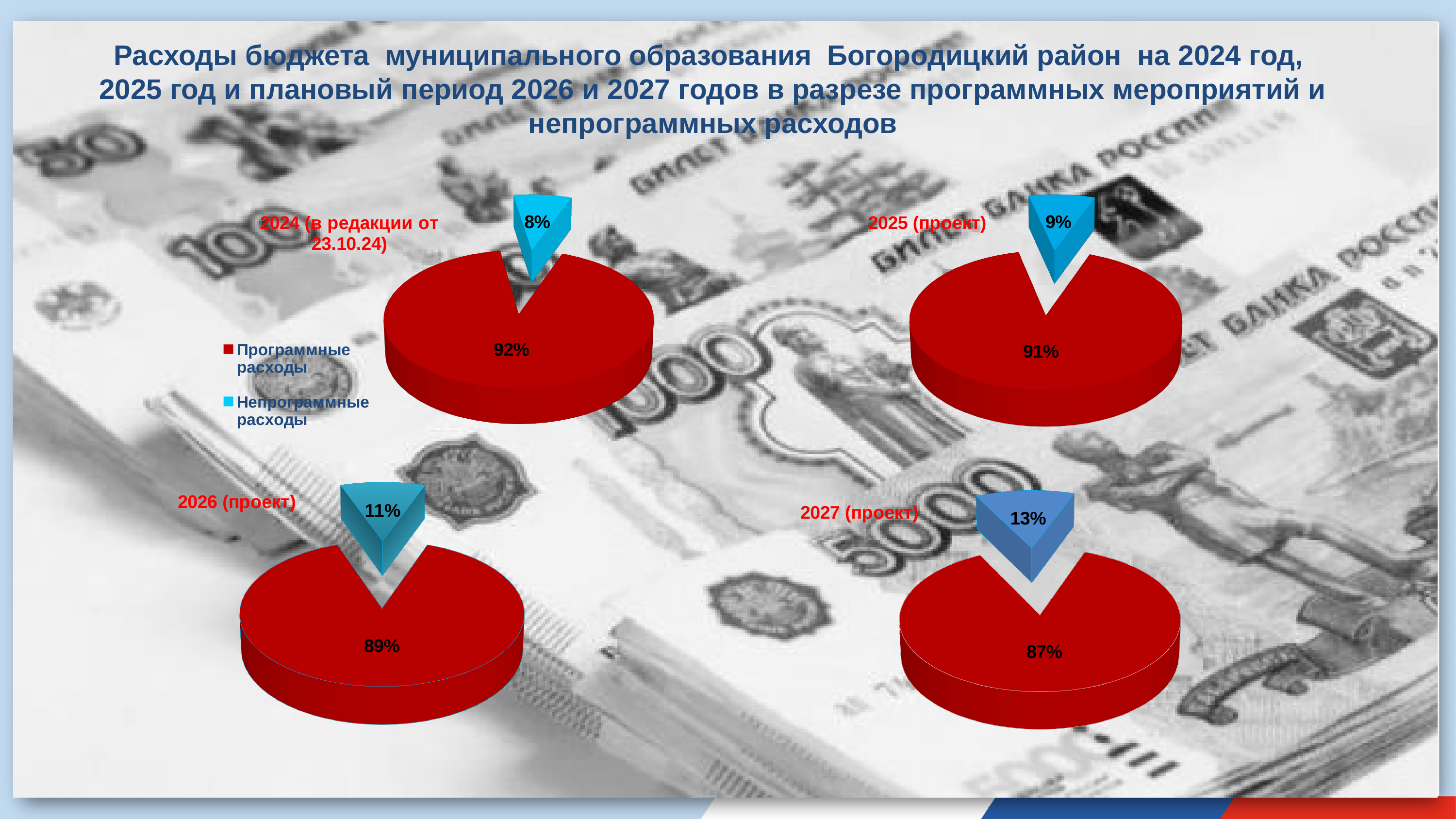
What kind of chart is used for each year on this slide? Pie chart In the 2025 (проект) pie chart, what share is Программные расходы? 91% How many pie charts are shown on the slide? 4 In the 2027 (проект) pie chart, what share is Программные расходы? 87% In the 2026 (проект) pie chart, which slice is larger: Программные расходы or Непрограммные расходы? Программные расходы How many series does the legend list? 2 In the 2024 (в редакции от 23.10.24) pie chart, what share is Программные расходы? 92% What is the difference between the Программные расходы share in the 2024 chart and in the 2027 (проект) chart? 5% Across the four pie charts, which year has the highest share of Непрограммные расходы? 2027 (проект) In the 2027 (проект) pie chart, what share is Непрограммные расходы? 13% In the 2026 (проект) pie chart, what share is Непрограммные расходы? 11% In the 2024 (в редакции от 23.10.24) pie chart, what share is Непрограммные расходы? 8%